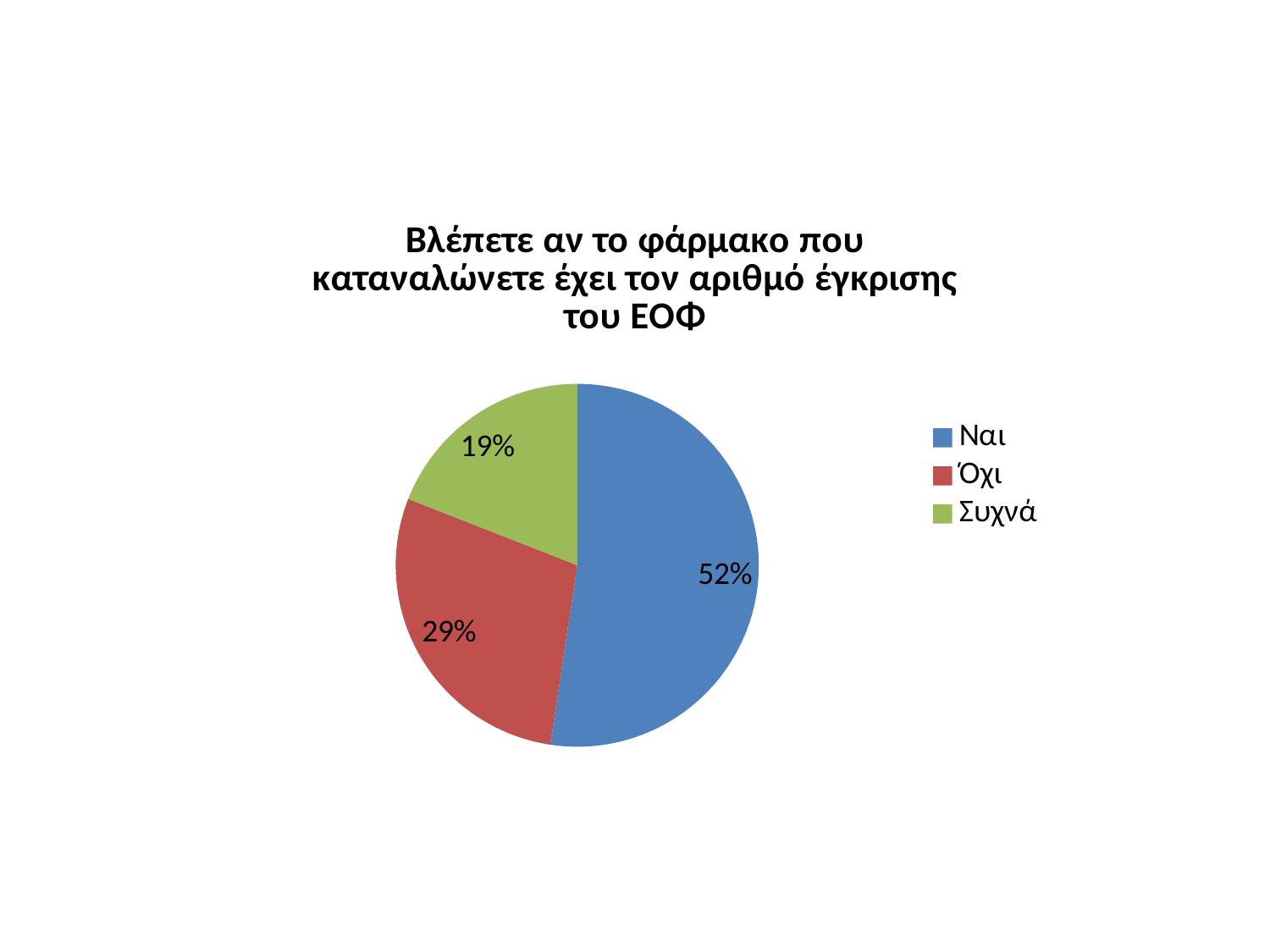
What is the difference in percentage points between the Όχι slice and the Συχνά slice? 10 Which legend entry is shown in red? Όχι How many slices does the pie chart have? 3 Which category has the smallest slice of the pie? Συχνά What percentage of the pie is labelled Όχι? 29% Which slice is larger, Όχι or Συχνά? Όχι What percentage of the pie is labelled Ναι? 52% Which category has the largest slice of the pie? Ναι What is the difference in percentage points between the Ναι slice and the Όχι slice? 23 What kind of chart is shown on the slide? Pie chart What colour is the slice for Συχνά? Green What percentage of the pie is labelled Συχνά? 19%